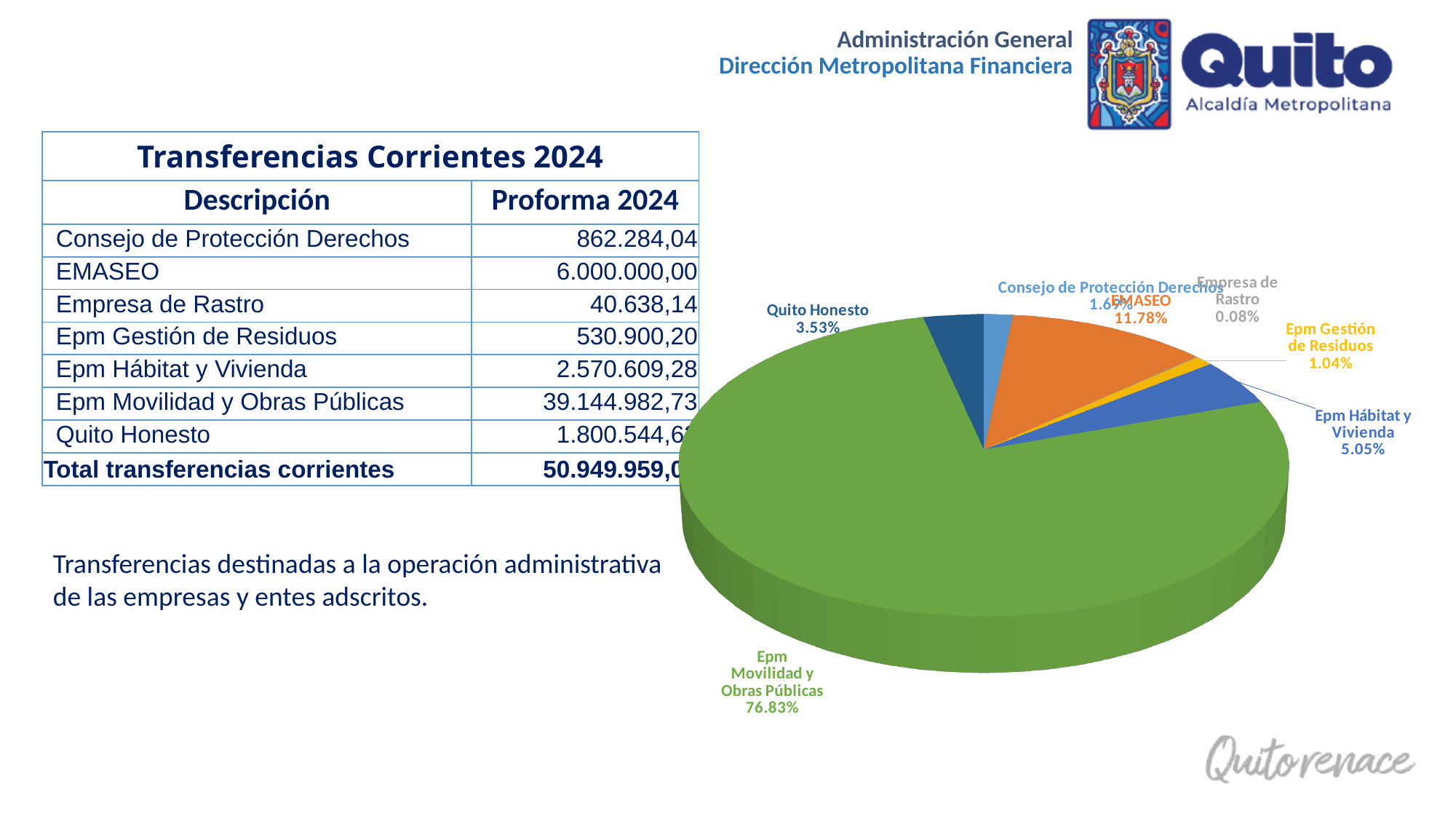
What share of the pie does Epm Movilidad y Obras Públicas represent? 76.83% What share of the pie does Epm Gestión de Residuos represent? 1.04% What is the difference in percentage points between the EMASEO slice and the Epm Hábitat y Vivienda slice? 6.73% What share of the pie does EMASEO represent? 11.78% Which slice of the pie chart is the smallest? Empresa de Rastro Which is larger in the pie chart, EMASEO or Quito Honesto? EMASEO What kind of chart is shown on the slide? pie chart Which slice of the pie chart is the largest? Epm Movilidad y Obras Públicas How many slices does the pie chart have? 7